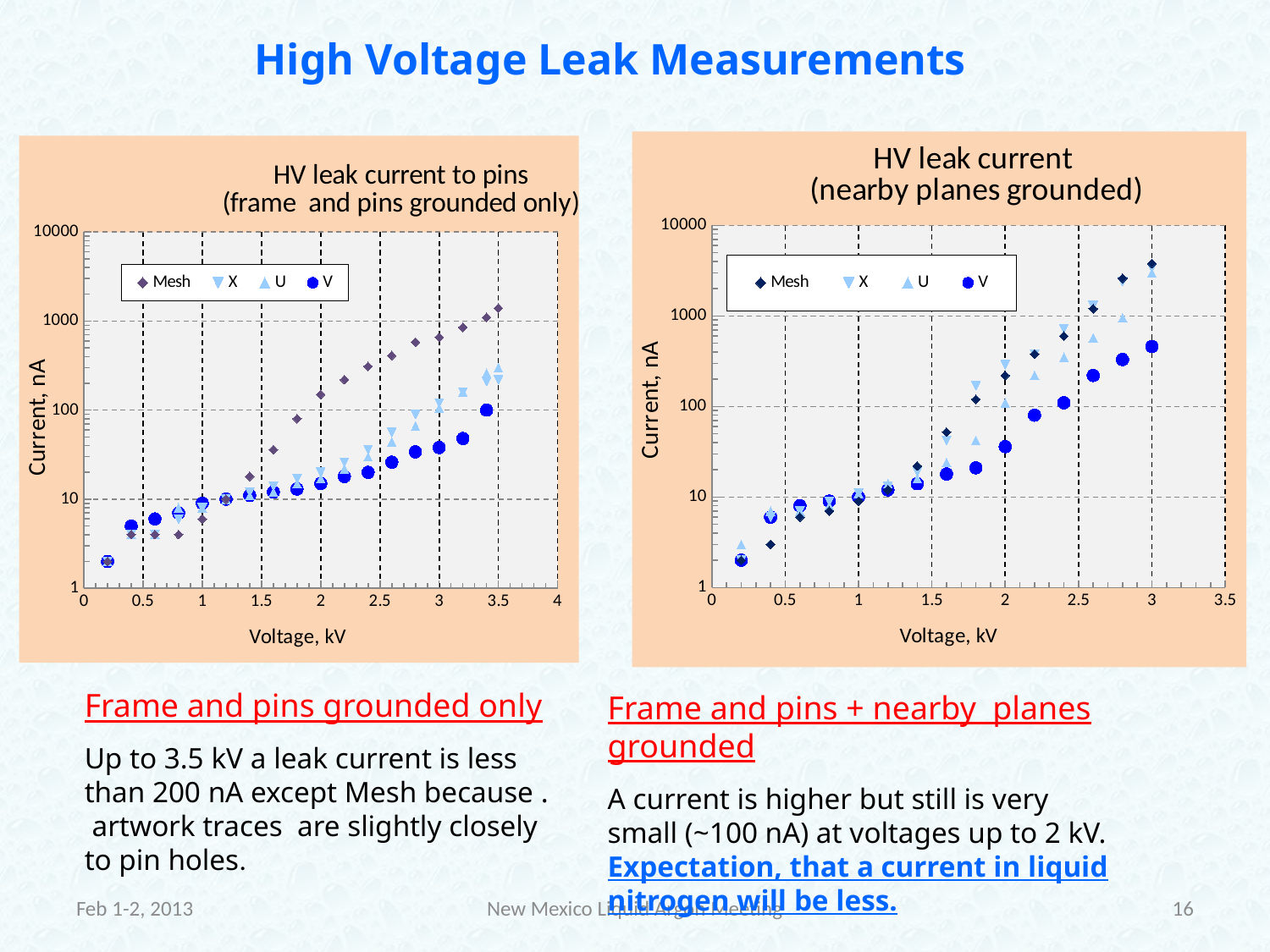
In the left chart, 'HV leak current to pins', which series has the higher current at 3.5 kV, Mesh or X? Mesh What is the x-axis title of the left chart, 'HV leak current to pins'? Voltage, kV In the left chart, 'HV leak current to pins', is the Mesh current at 3.5 kV greater or less than 1000 nA? greater In the right chart, 'HV leak current (nearby planes grounded)', is the Mesh current at 3 kV greater or less than 1000 nA? greater In the left chart, 'HV leak current to pins', which series are listed in the legend? Mesh, X, U, V In the right chart, 'HV leak current (nearby planes grounded)', is the V current at 2 kV greater or less than 100 nA? less How many series does the legend of the right chart, 'HV leak current (nearby planes grounded)', list? 4 In the right chart, 'HV leak current (nearby planes grounded)', which series has the higher current at 3 kV, Mesh or V? Mesh What type of chart is the left chart, 'HV leak current to pins (frame and pins grounded only)'? scatter chart In the right chart, 'HV leak current (nearby planes grounded)', does the Mesh current rise or fall as voltage increases? rises